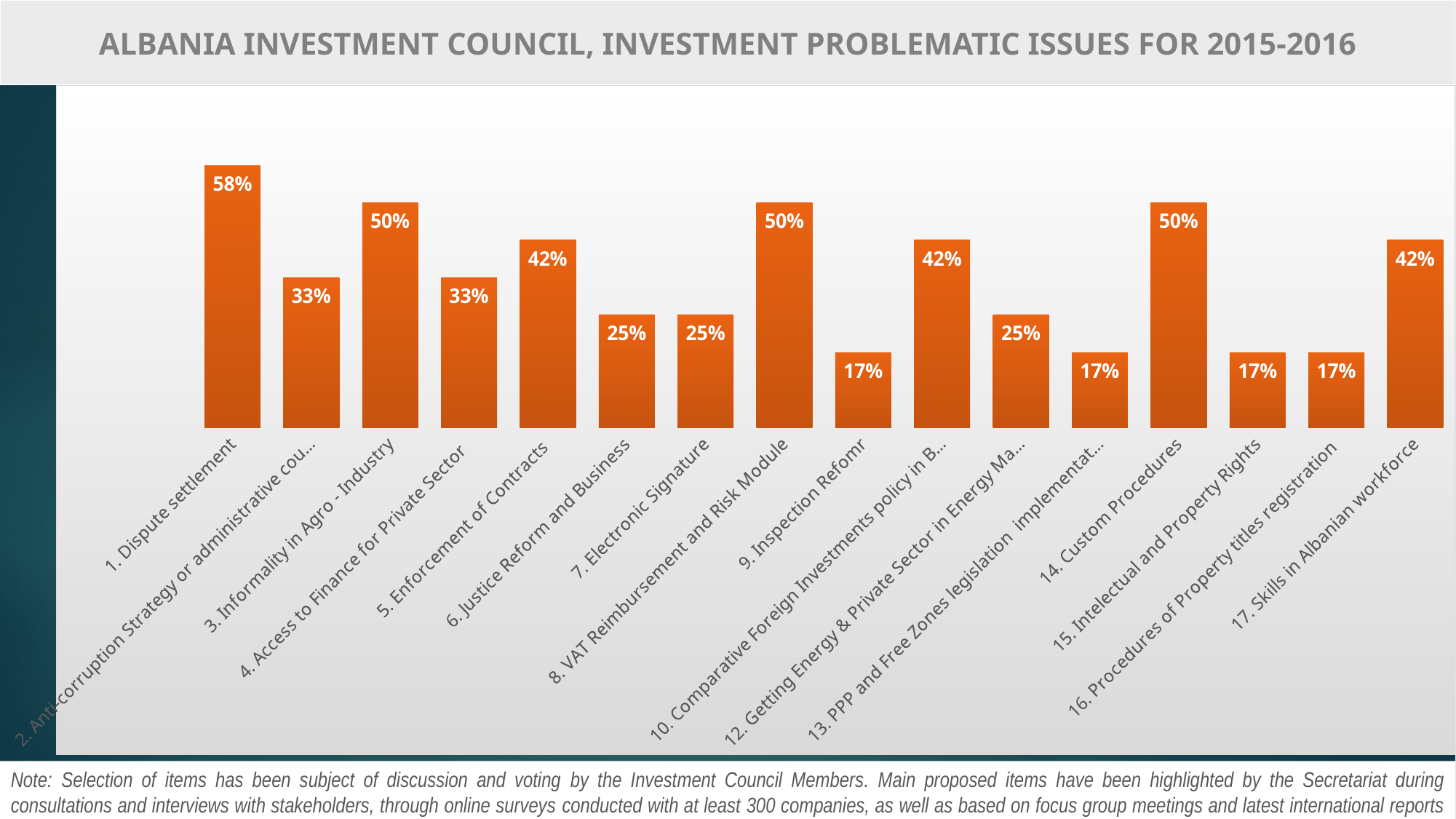
What is the value for 7. Electronic Signature? 25% Which is larger, the value for 5. Enforcement of Contracts or the value for 4. Access to Finance for Private Sector? 5. Enforcement of Contracts What is the value for 14. Custom Procedures? 50% How many bars are plotted on the chart? 16 What is the value for 9. Inspection Refomr? 17% What is the difference between the values for 1. Dispute settlement and 3. Informality in Agro - Industry? 8% Which category has the highest value? 1. Dispute settlement What type of chart is shown on the slide? bar chart What is the value for 17. Skills in Albanian workforce? 42% What is the value for 1. Dispute settlement? 58% What is the lowest value shown on the chart? 17% What is the title of the chart? ALBANIA INVESTMENT COUNCIL, INVESTMENT PROBLEMATIC ISSUES FOR 2015-2016